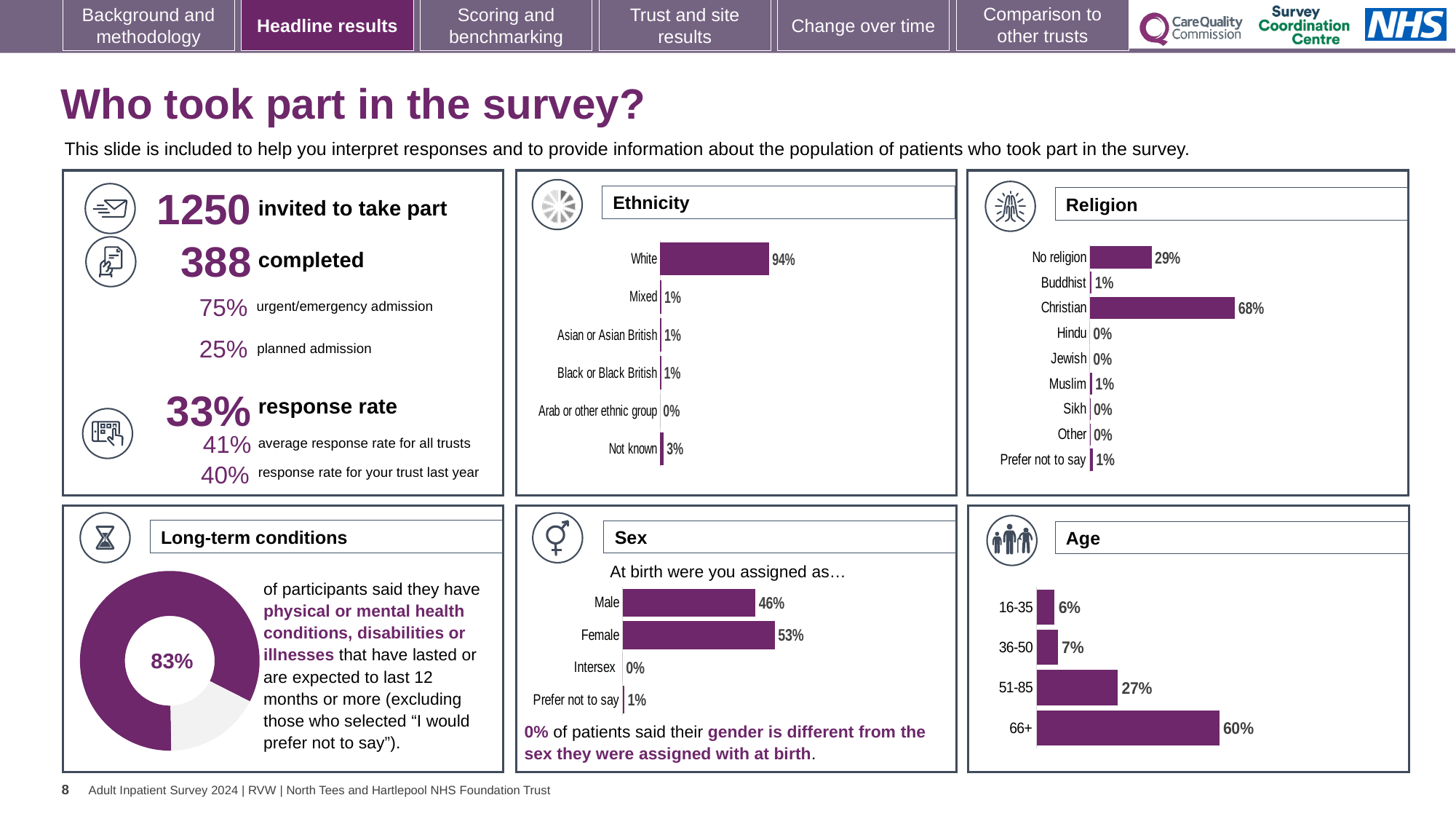
How many categories are shown in the Religion chart? 9 In the Age chart, do the values rise or fall as the age groups increase? rise In the Religion chart, what is the difference between the Christian and No religion percentages? 39% In the Religion chart, what percentage of respondents said they have no religion? 29% In the Sex chart, what is the difference between the Female and Male percentages? 7% In the Ethnicity chart, what percentage of respondents were White? 94% In the Ethnicity chart, what percentage of respondents were recorded as Not known? 3% In the Religion chart, which category has the highest value? Christian What kind of chart is used in the Long-term conditions panel? doughnut chart In the Age chart, which age group has the highest value? 66+ In the Sex chart, which is larger, Male or Female? Female In the Age chart, what percentage of respondents were aged 51-85? 27%